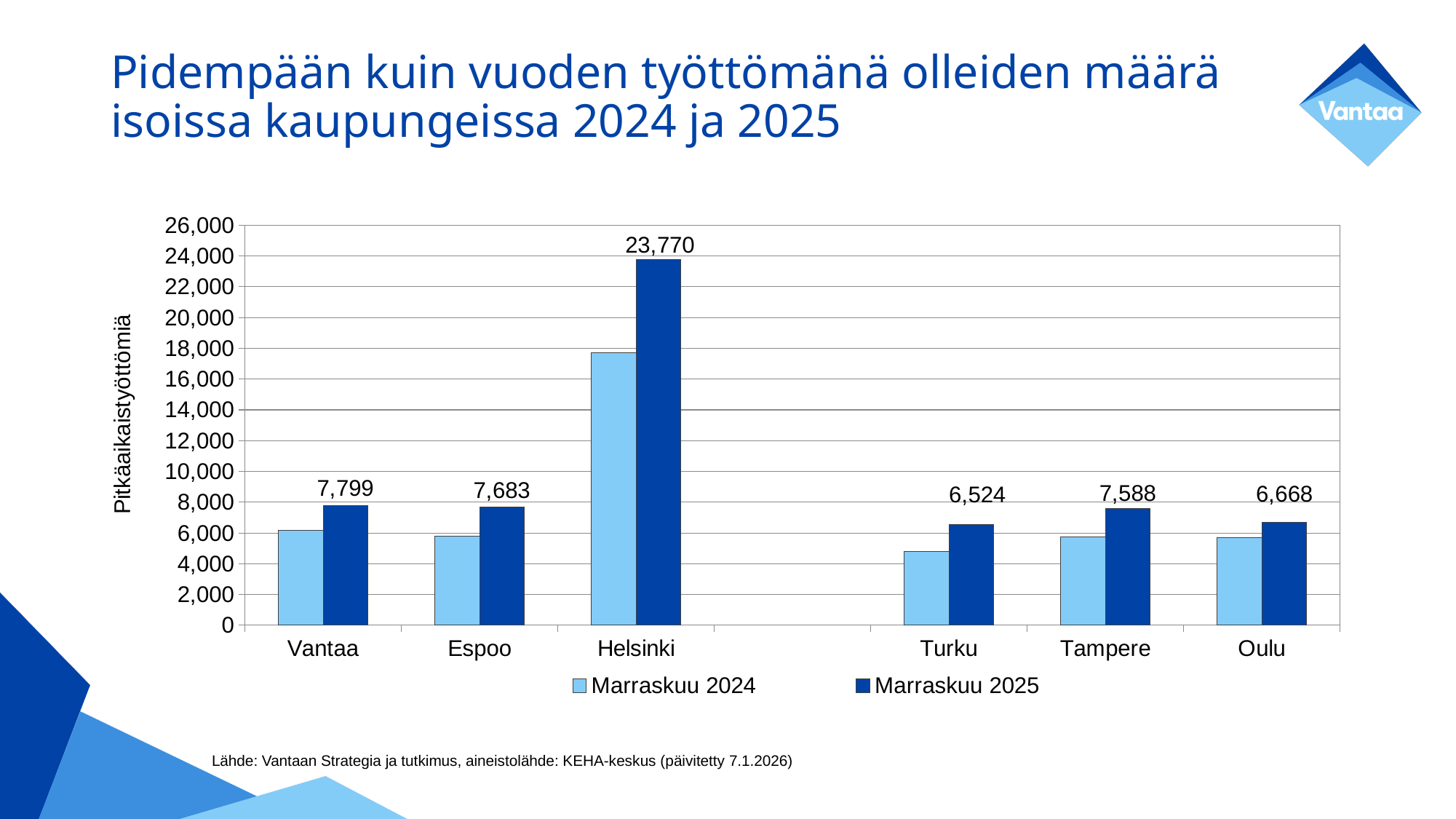
How many cities are shown on the x axis? 6 What is the difference between the Marraskuu 2025 values for Helsinki and Vantaa? 15,971 Which is larger in Marraskuu 2025, Tampere or Oulu? Tampere Which city has the lowest value in Marraskuu 2025? Turku What is the difference between the Marraskuu 2025 values for Vantaa and Espoo? 116 What is the value for Vantaa in Marraskuu 2025? 7,799 Is the value for Helsinki in Marraskuu 2024 greater or less than 16,000? greater Which city has the highest value in Marraskuu 2025? Helsinki Is the value for Turku in Marraskuu 2024 greater or less than 6,000? less What is the value for Turku in Marraskuu 2025? 6,524 How many series does the legend list? 2 What is the value for Helsinki in Marraskuu 2025? 23,770